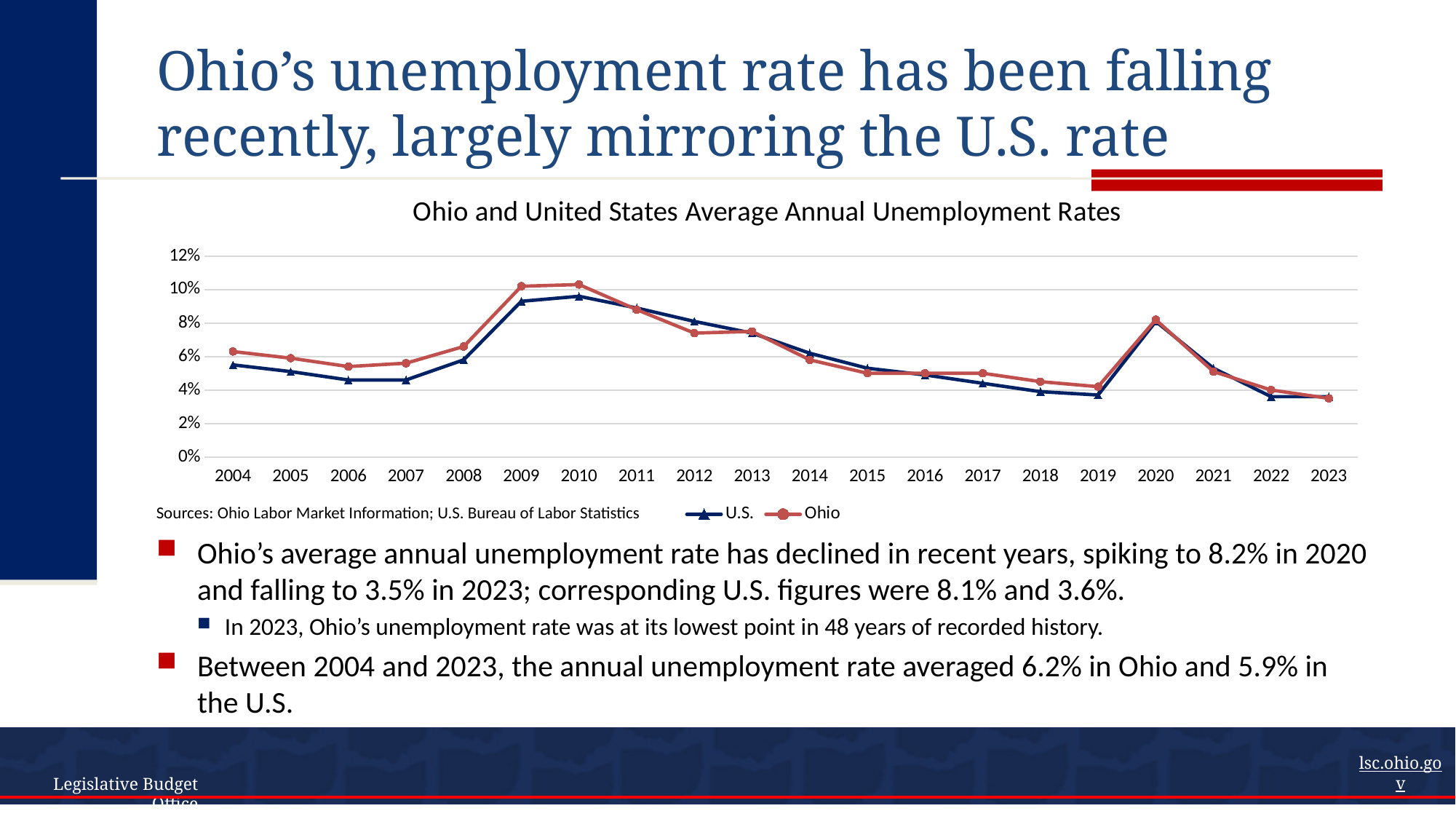
What is the title of the chart? Ohio and United States Average Annual Unemployment Rates Is the U.S. unemployment rate for 2006 greater or less than 6%? less Is the Ohio unemployment rate for 2015 greater or less than 6%? less How many series does the chart's legend list? 2 Is the Ohio unemployment rate for 2009 greater or less than 8%? greater In 2012, which series has the higher unemployment rate, U.S. or Ohio? U.S. What kind of chart is shown on the slide? line chart How many years are plotted along the x axis of the chart? 20 In 2009, which series has the higher unemployment rate, U.S. or Ohio? Ohio Does the U.S. unemployment rate rise or fall from 2010 to 2019? fall In which year is Ohio's unemployment rate lowest on the chart? 2023 Which series is drawn with the red line and circle markers? Ohio